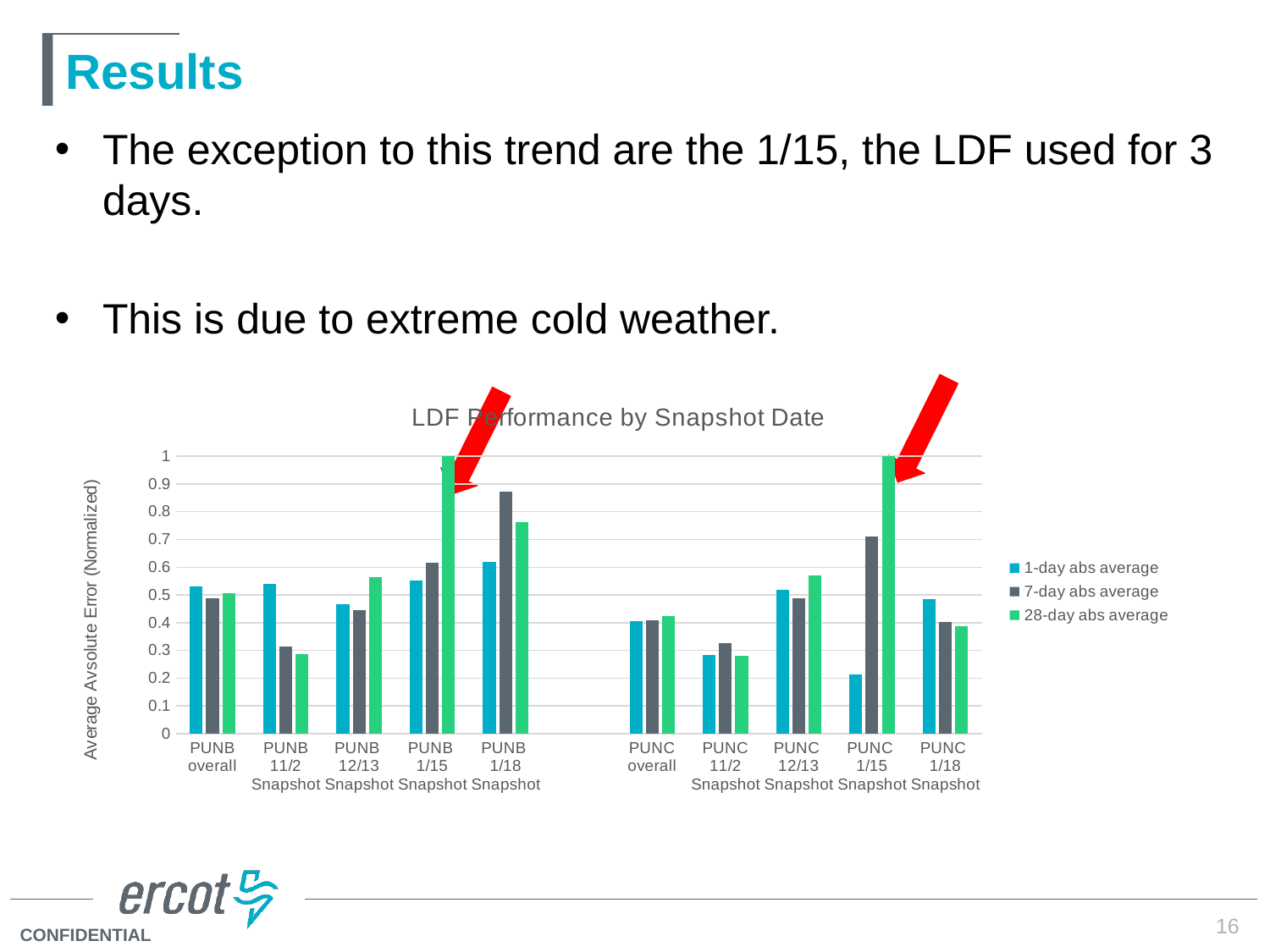
Is the 7-day abs average value for PUNB 1/18 Snapshot greater or less than 0.8? greater For PUNB 11/2 Snapshot, which is larger: the 1-day abs average or the 7-day abs average? 1-day abs average Which category has the highest 1-day abs average value? PUNB 1/18 Snapshot Is the 1-day abs average value for PUNC 1/15 Snapshot greater or less than 0.3? less Which category has the lowest 1-day abs average value? PUNC 1/15 Snapshot For PUNB 1/18 Snapshot, which is larger: the 7-day abs average or the 28-day abs average? 7-day abs average Which series in the legend is shown in green? 28-day abs average How many labeled categories are shown on the x axis of the chart? 10 What is the 28-day abs average value for PUNB 1/15 Snapshot? 1 What type of chart is shown on the slide? bar chart How many series does the legend of the LDF Performance by Snapshot Date chart list? 3 What is the title of the chart? LDF Performance by Snapshot Date